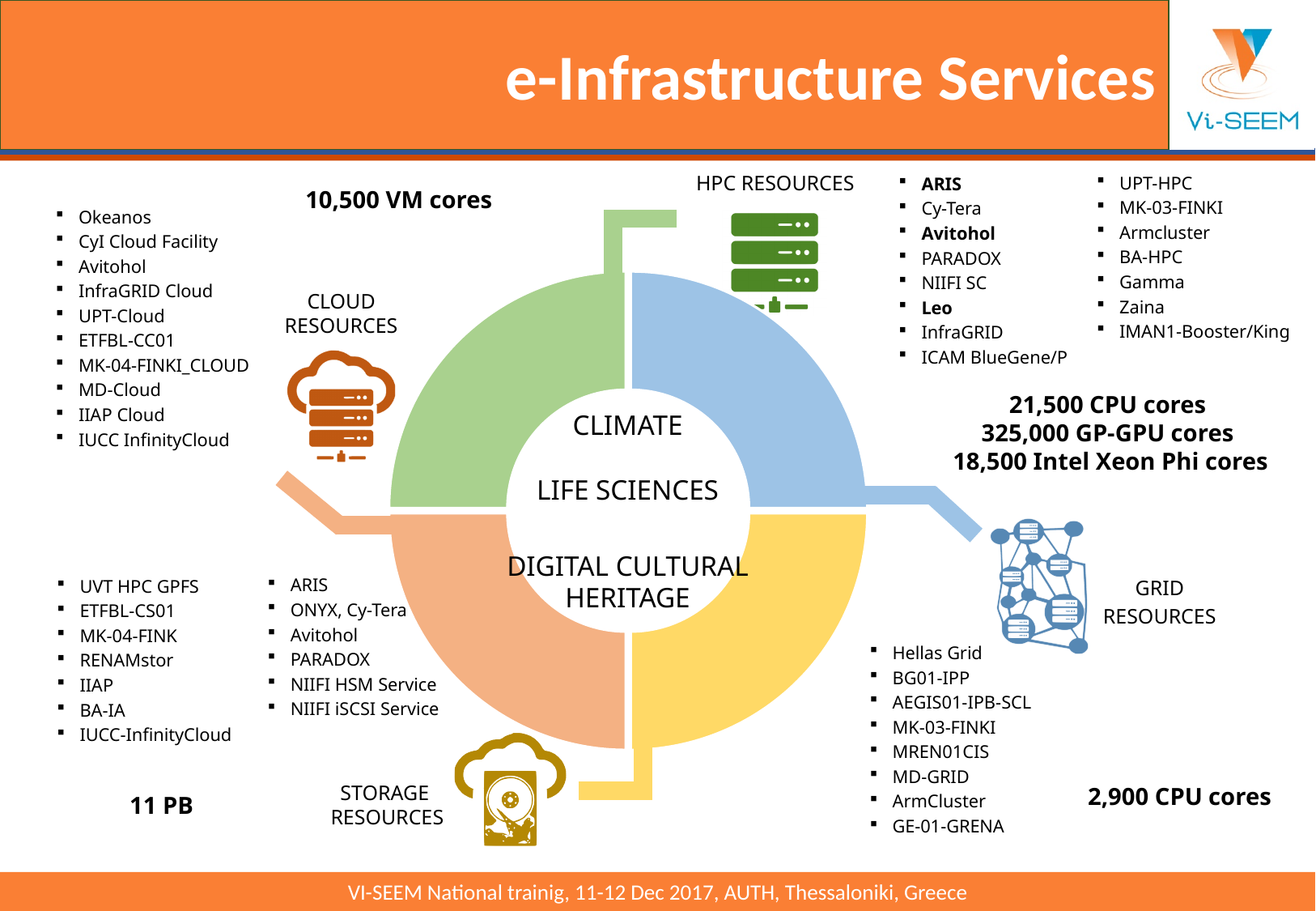
What is the difference between the HPC CPU cores and the Grid CPU cores? 18,600 How many Intel Xeon Phi cores are listed for the HPC Resources segment? 18,500 Intel Xeon Phi cores Which has more CPU cores, the HPC Resources or the Grid Resources? HPC Resources How many GP-GPU cores are listed for the HPC Resources segment? 325,000 GP-GPU cores How many sites are listed under Grid Resources? 8 What total capacity is listed for the Storage Resources segment? 11 PB How many VM cores are listed for the Cloud Resources segment of the diagram? 10,500 VM cores Which resource segment of the ring is coloured green? HPC Resources How many CPU cores are listed for the HPC Resources segment? 21,500 CPU cores How many CPU cores are listed for the Grid Resources segment? 2,900 CPU cores How many resource segments does the ring diagram have? 4 What three application areas are written in the centre of the ring? Climate, Life Sciences, Digital Cultural Heritage